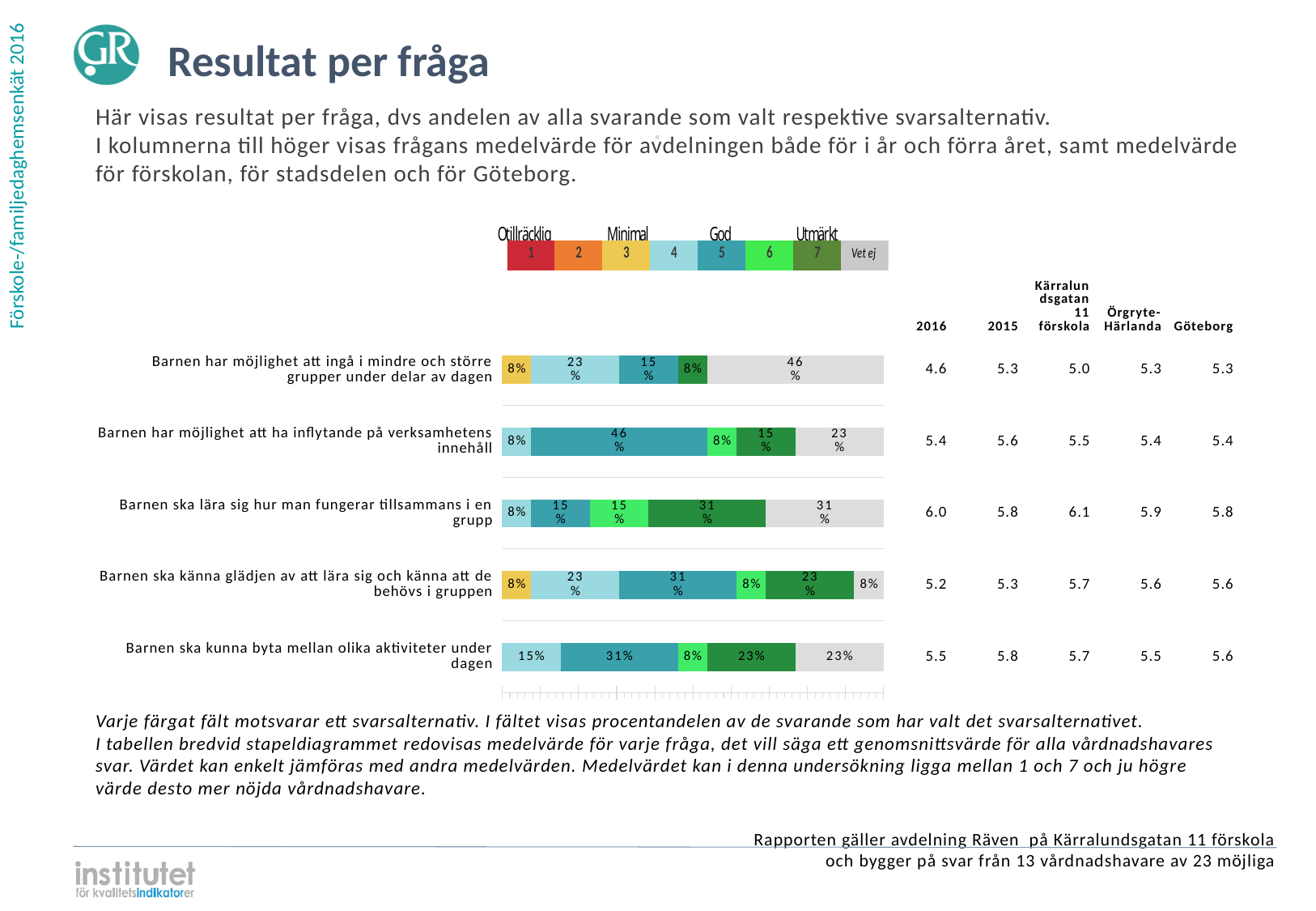
Which question has the smallest 'Vet ej' share? Barnen ska känna glädjen av att lära sig och känna att de behövs i gruppen Which question has the largest 'Vet ej' share? Barnen har möjlighet att ingå i mindre och större grupper under delar av dagen What percentage chose answer 4 (the light blue segment) for 'Barnen ska kunna byta mellan olika aktiviteter under dagen'? 15% What percentage of respondents answered 'Vet ej' for 'Barnen har möjlighet att ingå i mindre och större grupper under delar av dagen'? 46% What is the difference between the 'Vet ej' share for 'Barnen har möjlighet att ingå i mindre och större grupper under delar av dagen' (46%) and for 'Barnen ska kunna byta mellan olika aktiviteter under dagen' (23%)? 23 percentage points Which colour in the legend represents the 'Vet ej' response? Grey What percentage answered 'Vet ej' for 'Barnen ska känna glädjen av att lära sig och känna att de behövs i gruppen'? 8% How many questions (bars) are shown in the chart? 5 What percentage chose answer 5 (the teal segment) for 'Barnen har möjlighet att ha inflytande på verksamhetens innehåll'? 46% How many response categories does the legend above the chart list (including 'Vet ej')? 8 What percentage chose answer 7 (the dark green segment) for 'Barnen ska lära sig hur man fungerar tillsammans i en grupp'? 31% What kind of chart is used to show the results per question on this slide? Stacked bar chart